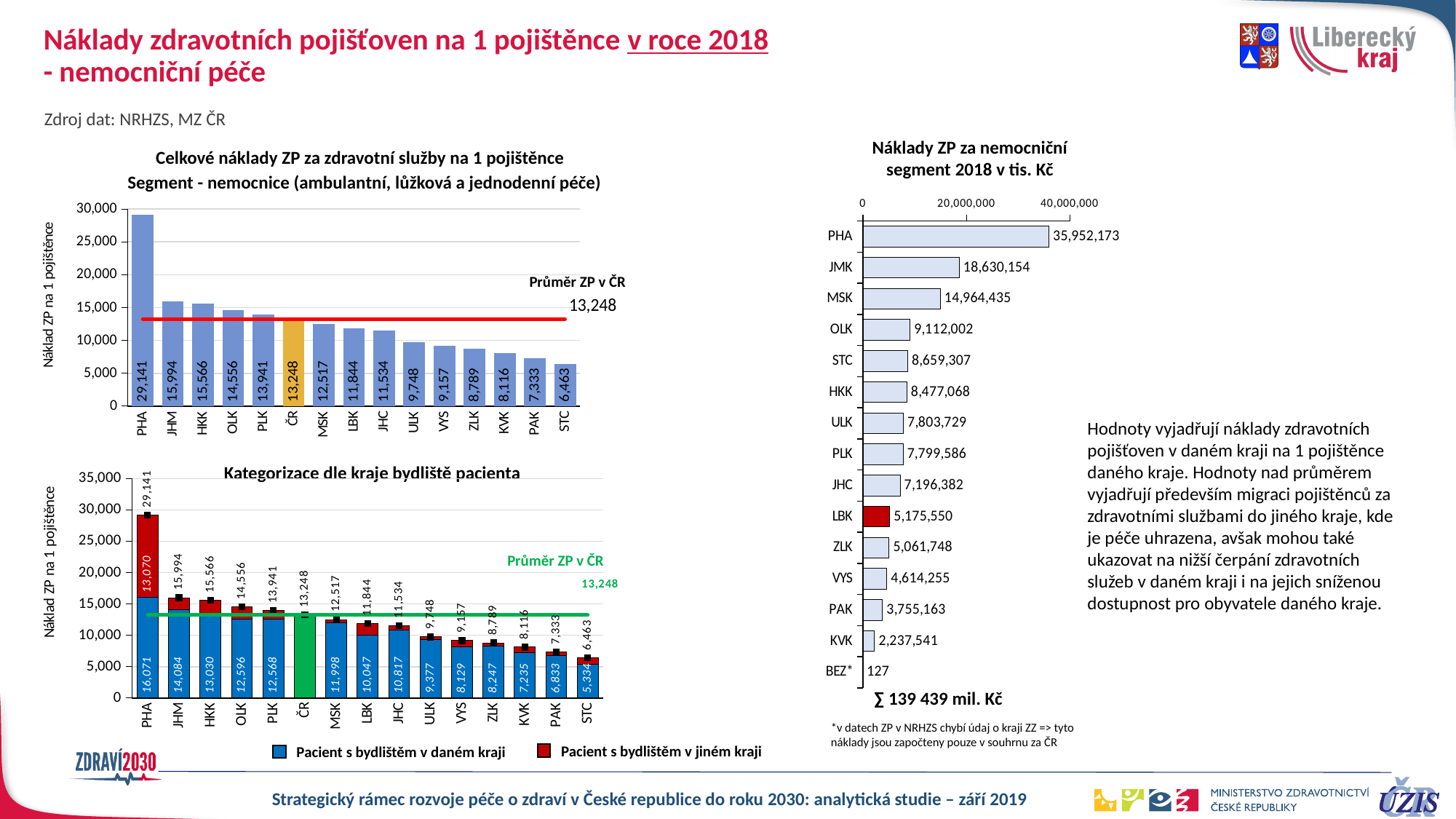
In the right chart 'Náklady ZP za nemocniční segment 2018 v tis. Kč', which is larger, the value for ULK or the value for JHC? ULK In the top-left chart 'Celkové náklady ZP za zdravotní služby na 1 pojištěnce', which category has the lowest value? STC What kind of chart is the right chart 'Náklady ZP za nemocniční segment 2018 v tis. Kč'? Bar chart In the bottom-left chart 'Kategorizace dle kraje bydliště pacienta', what is the value of the 'Pacient s bydlištěm v daném kraji' segment for PHA? 16,071 In the top-left chart 'Celkové náklady ZP za zdravotní služby na 1 pojištěnce', which region has the highest value? PHA In the top-left chart 'Celkové náklady ZP za zdravotní služby na 1 pojištěnce', what is the value for LBK? 11,844 In the top-left chart 'Celkové náklady ZP za zdravotní služby na 1 pojištěnce', what is the difference between the values for PHA and JHM? 13,147 In the top-left chart 'Celkové náklady ZP za zdravotní služby na 1 pojištěnce', what is the value of the 'Průměr ZP v ČR' line? 13,248 In the bottom-left chart 'Kategorizace dle kraje bydliště pacienta', what is the total of the stacked bar for STC? 6,463 In the bottom-left chart 'Kategorizace dle kraje bydliště pacienta', what is the value of the 'Pacient s bydlištěm v jiném kraji' segment for PHA? 13,070 In the bottom-left chart 'Kategorizace dle kraje bydliště pacienta', how many series does the legend list? 2 In the right chart 'Náklady ZP za nemocniční segment 2018 v tis. Kč', what is the value for LBK? 5,175,550